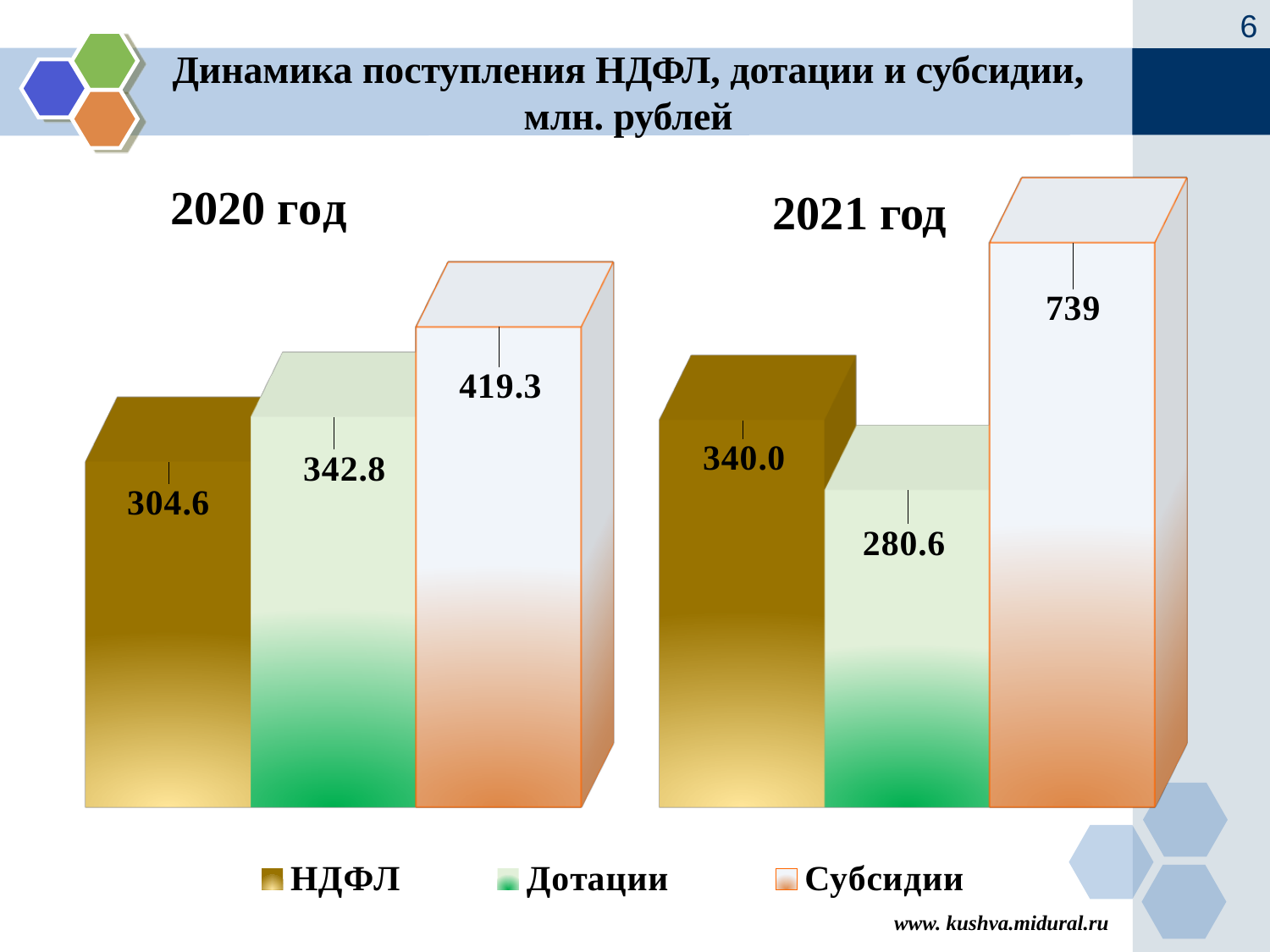
What is the title of the chart? Динамика поступления НДФЛ, дотации и субсидии, млн. рублей Which is larger: НДФЛ in 2020 год or НДФЛ in 2021 год? НДФЛ in 2021 год Which series has the highest value in 2021 год? Субсидии What is the value for Субсидии in 2021 год? 739 What is the difference between Субсидии in 2021 год and Субсидии in 2020 год? 319.7 What is the value for Дотации in 2020 год? 342.8 What kind of chart is shown on the slide? Bar chart Which series has the lowest value in 2020 год? НДФЛ What is the value for НДФЛ in 2020 год? 304.6 How many year groups are shown on the chart? 2 What is the value for Дотации in 2021 год? 280.6 How many series does the legend list? 3